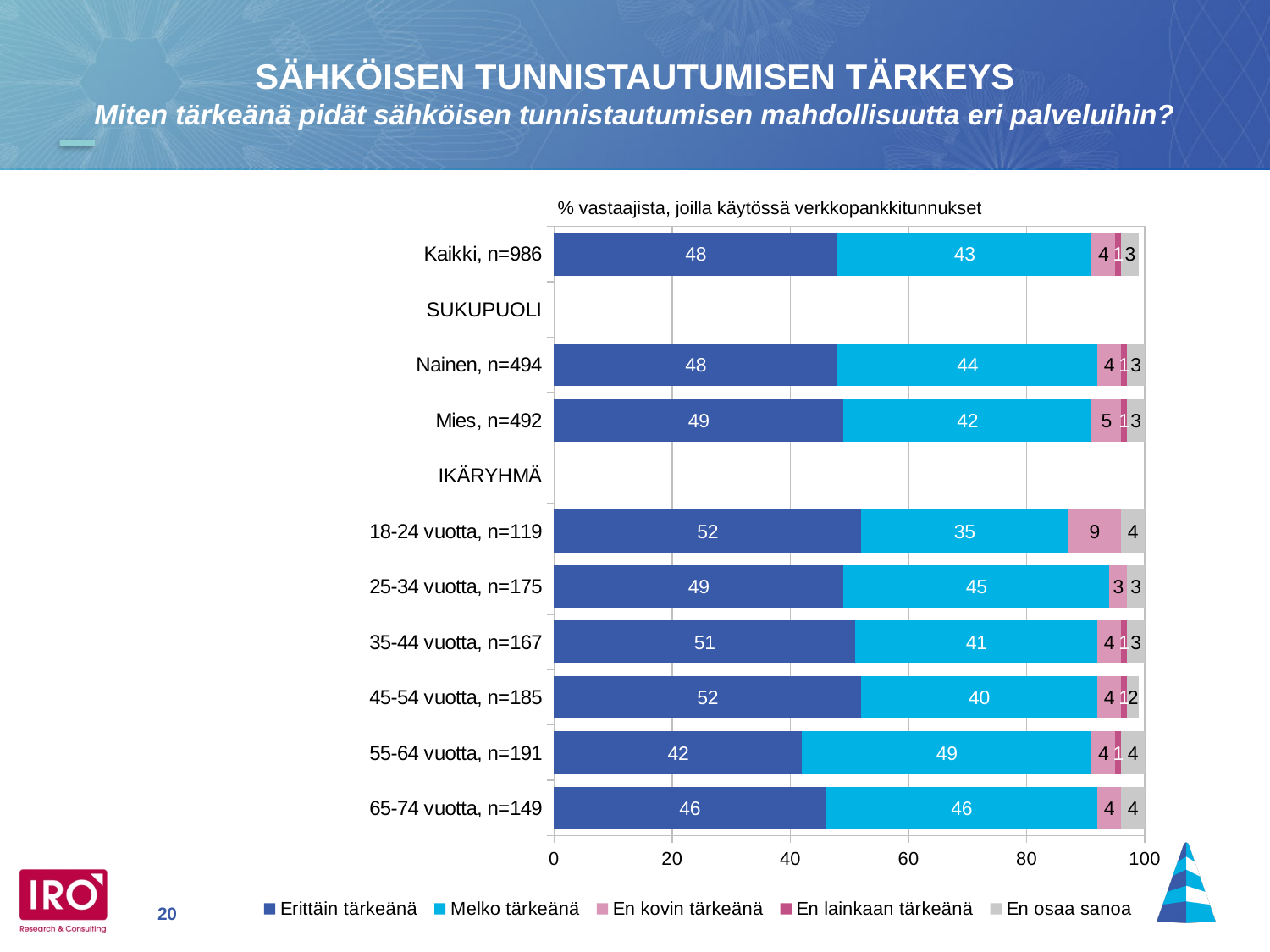
Which category has the highest value for "En kovin tärkeänä"? 18-24 vuotta, n=119 Which category has the highest value for "Melko tärkeänä"? 55-64 vuotta, n=191 What is the value for "Erittäin tärkeänä" in the "Kaikki, n=986" bar? 48 What is the text shown above the chart describing the respondents? % vastaajista, joilla käytössä verkkopankkitunnukset For "55-64 vuotta, n=191", which is larger: "Erittäin tärkeänä" or "Melko tärkeänä"? Melko tärkeänä What kind of chart is shown on the slide? Stacked bar chart What is the difference between the "Erittäin tärkeänä" and "Melko tärkeänä" values for "Kaikki, n=986"? 5 Which category has the lowest value for "Erittäin tärkeänä"? 55-64 vuotta, n=191 What is the value for "En kovin tärkeänä" in the "Mies, n=492" bar? 5 How many series does the legend list? 5 What is the value for "Melko tärkeänä" in the "18-24 vuotta, n=119" bar? 35 How many categories have data bars plotted in the chart? 9